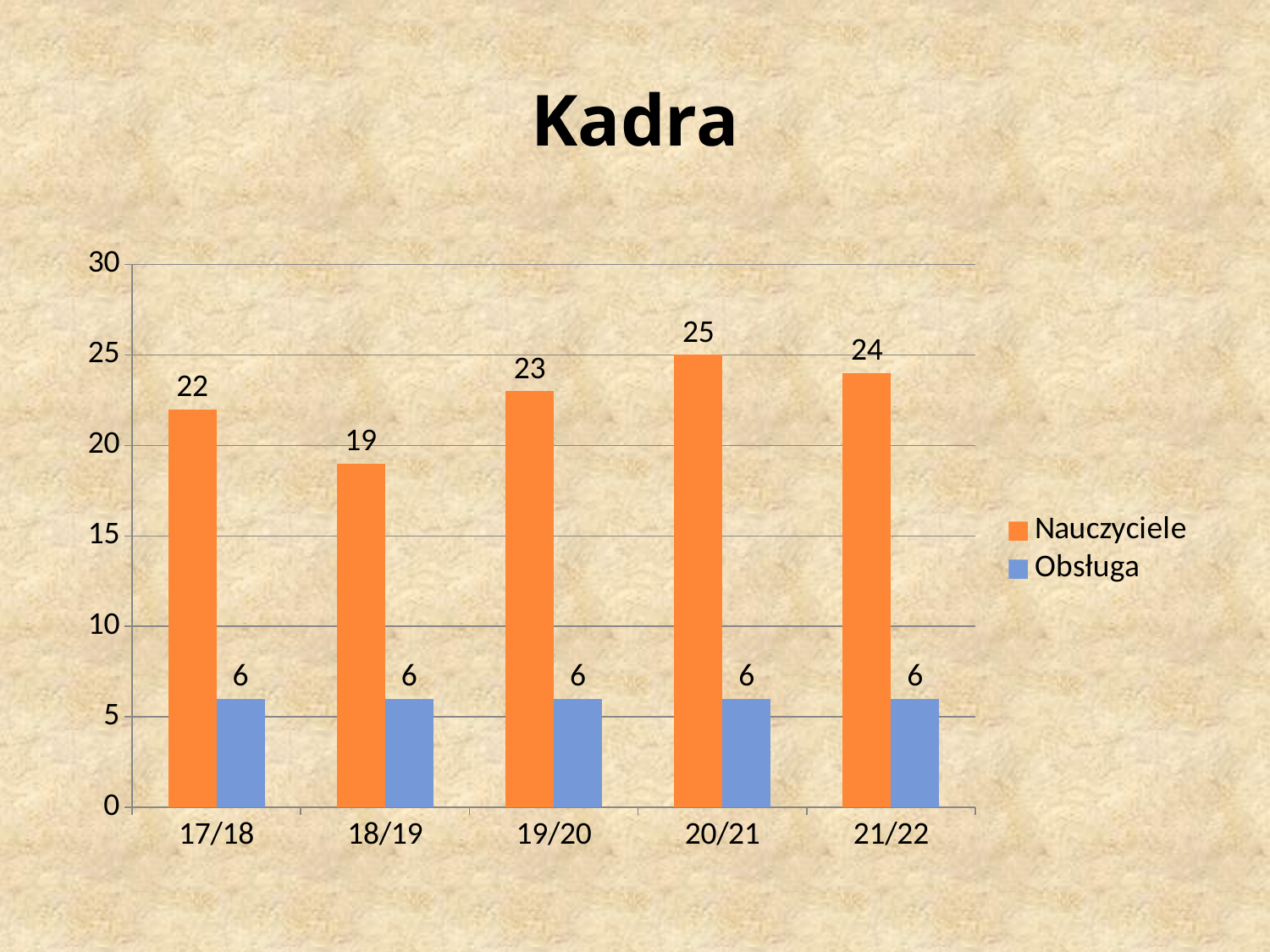
Which is larger, the Nauczyciele value for 19/20 or for 21/22? 21/22 What is the title of the slide? Kadra What kind of chart is shown on the slide? bar chart What is the value for Obsługa in 19/20? 6 How many series does the legend list? 2 In which year is the Nauczyciele value lowest? 18/19 What is the value for Nauczyciele in 20/21? 25 What is the value for Nauczyciele in 17/18? 22 How many years are shown on the x axis? 5 In which year is the Nauczyciele value highest? 20/21 What is the difference between the Nauczyciele values for 20/21 and 18/19? 6 Does the Obsługa value change across the years shown? No, it stays at 6